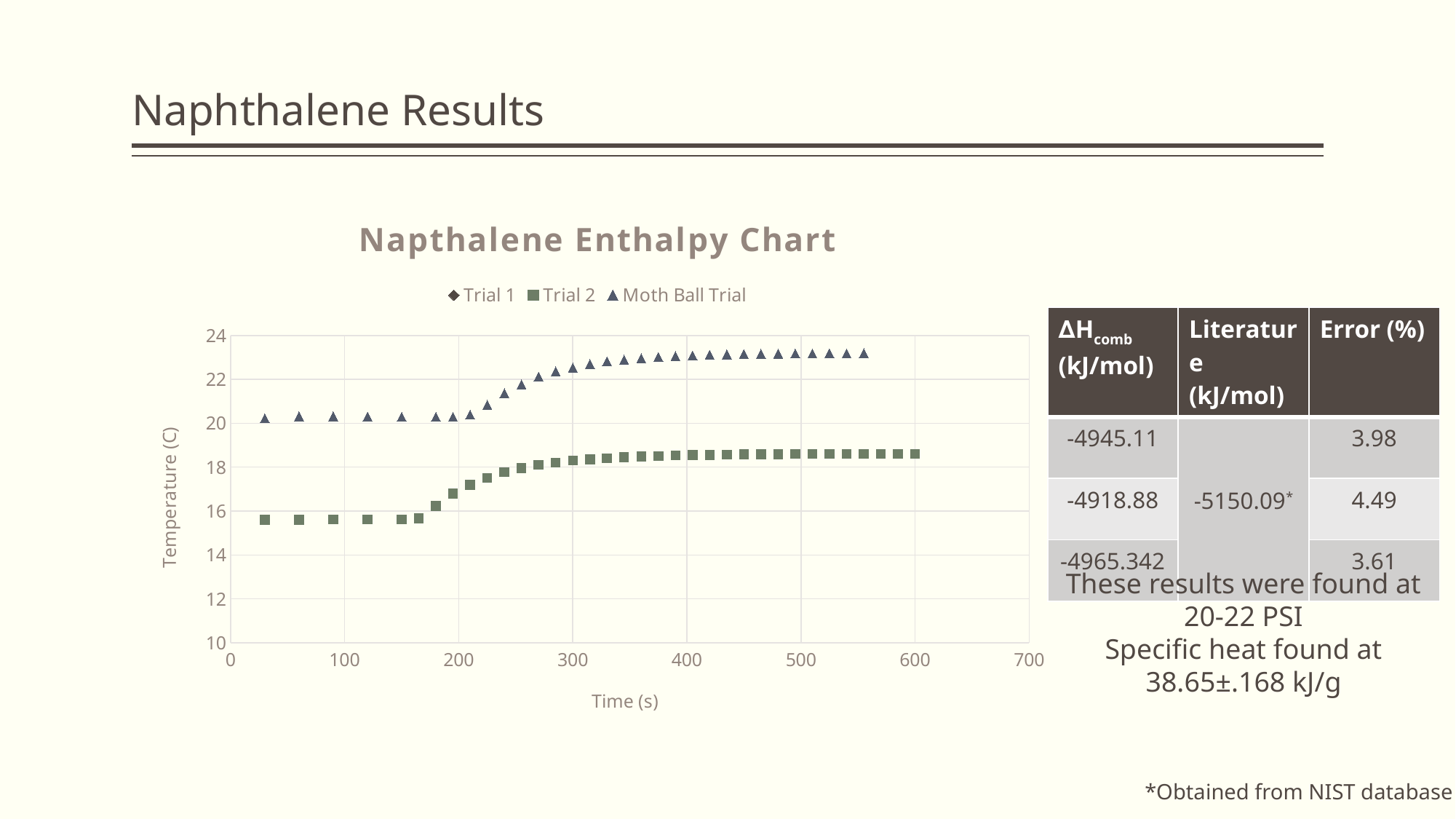
Is the Trial 2 temperature at 500 s greater or less than 18? greater What kind of chart is shown on the slide? scatter chart Is the Moth Ball Trial temperature at 100 s greater or less than 22? less What is the title of the chart? Napthalene Enthalpy Chart Is the Trial 2 temperature at 30 s greater or less than 16? less Do the Moth Ball Trial temperatures rise or fall overall as time increases along the x axis? rise At 500 s, which series has the higher temperature, Trial 2 or Moth Ball Trial? Moth Ball Trial Which series reaches the highest temperature on the chart? Moth Ball Trial What is the label of the x axis of the chart? Time (s) How many series does the chart legend list? 3 Do the Trial 2 temperatures rise or fall overall as time increases along the x axis? rise